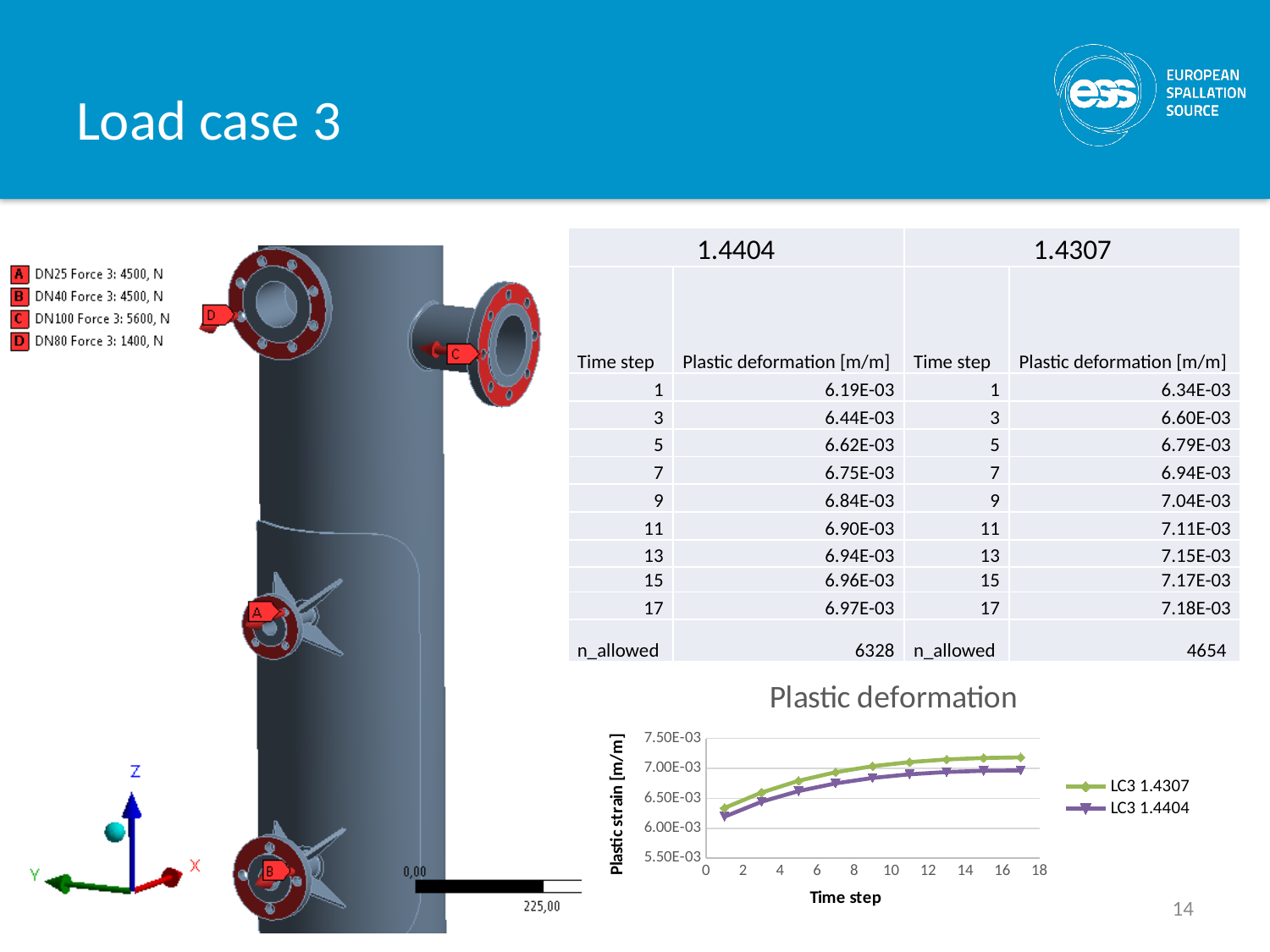
In the "Plastic deformation" chart, at which time step does LC3 1.4307 reach its highest value? 17 In the "Plastic deformation" chart, is the value of LC3 1.4307 at time step 17 greater or less than 7.00E-03? greater What kind of chart is the "Plastic deformation" chart? line chart How many series does the legend of the "Plastic deformation" chart list? 2 How many data points does each series in the "Plastic deformation" chart have? 9 According to the slide, what is the plastic deformation for material 1.4307 at time step 1? 6.34E-03 According to the slide, what is the plastic deformation for material 1.4404 at time step 17? 6.97E-03 What is the title of the y axis in the "Plastic deformation" chart? Plastic strain [m/m] In the "Plastic deformation" chart, which series is higher at time step 17, LC3 1.4307 or LC3 1.4404? LC3 1.4307 In the "Plastic deformation" chart, is the value of LC3 1.4404 at time step 1 greater or less than 6.50E-03? less In the "Plastic deformation" chart, do the values of LC3 1.4307 rise or fall as the time step increases? rise What are the two legend entries in the "Plastic deformation" chart? LC3 1.4307 and LC3 1.4404